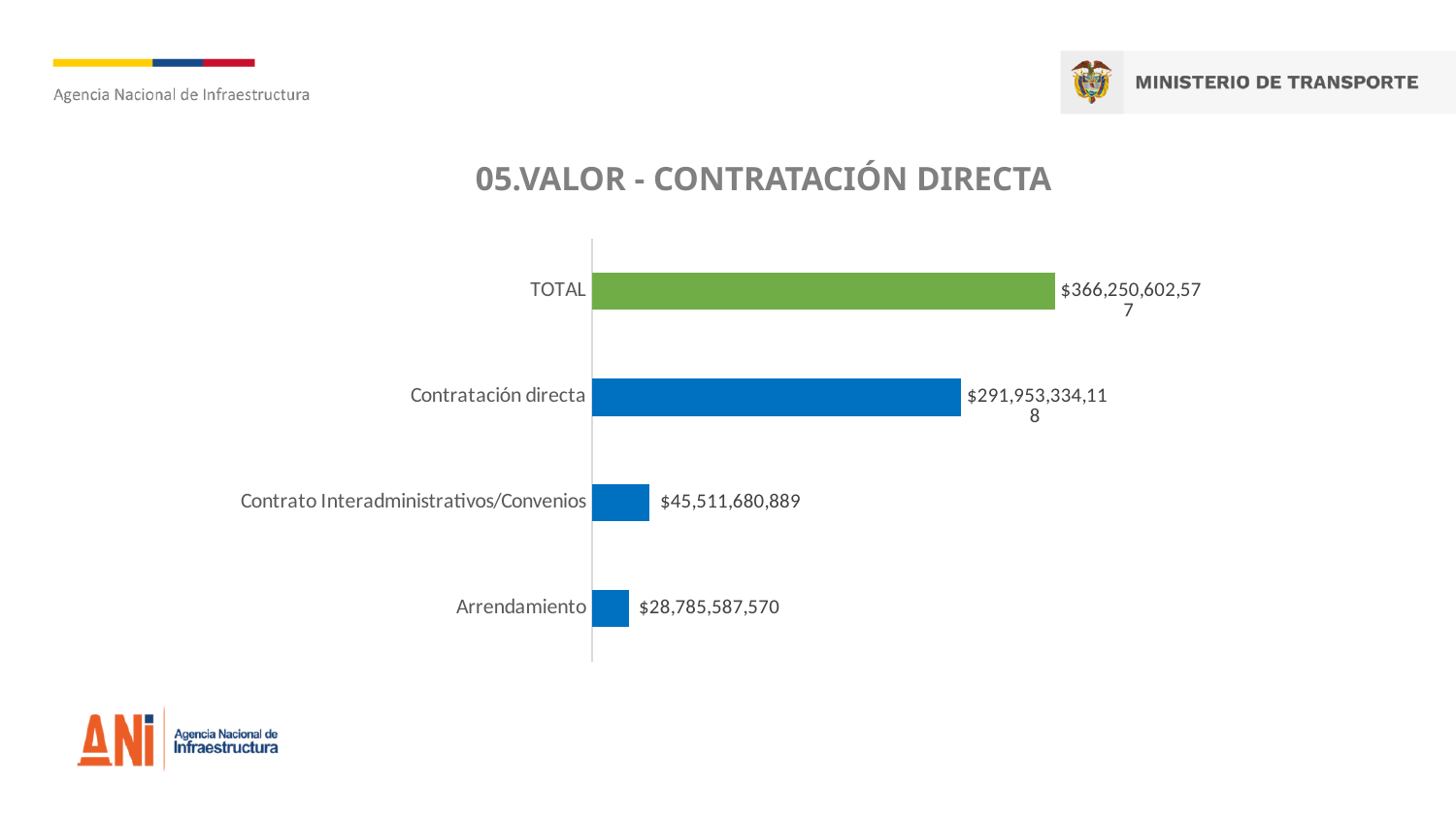
What is the difference between Contratación directa and Contrato Interadministrativos/Convenios? $246,441,653,229 What kind of chart is shown on the slide? Bar chart What is the title of the chart? 05.VALOR - CONTRATACIÓN DIRECTA What is the value for Contratación directa? $291,953,334,118 Which category has the lowest value? Arrendamiento What is the value for Arrendamiento? $28,785,587,570 Excluding the TOTAL bar, which category has the highest value? Contratación directa What is the value shown for the TOTAL bar? $366,250,602,577 What is the value for Contrato Interadministrativos/Convenios? $45,511,680,889 What is the difference between Contrato Interadministrativos/Convenios and Arrendamiento? $16,726,093,319 How many bars are shown in the chart? 4 Which is larger, Contrato Interadministrativos/Convenios or Arrendamiento? Contrato Interadministrativos/Convenios